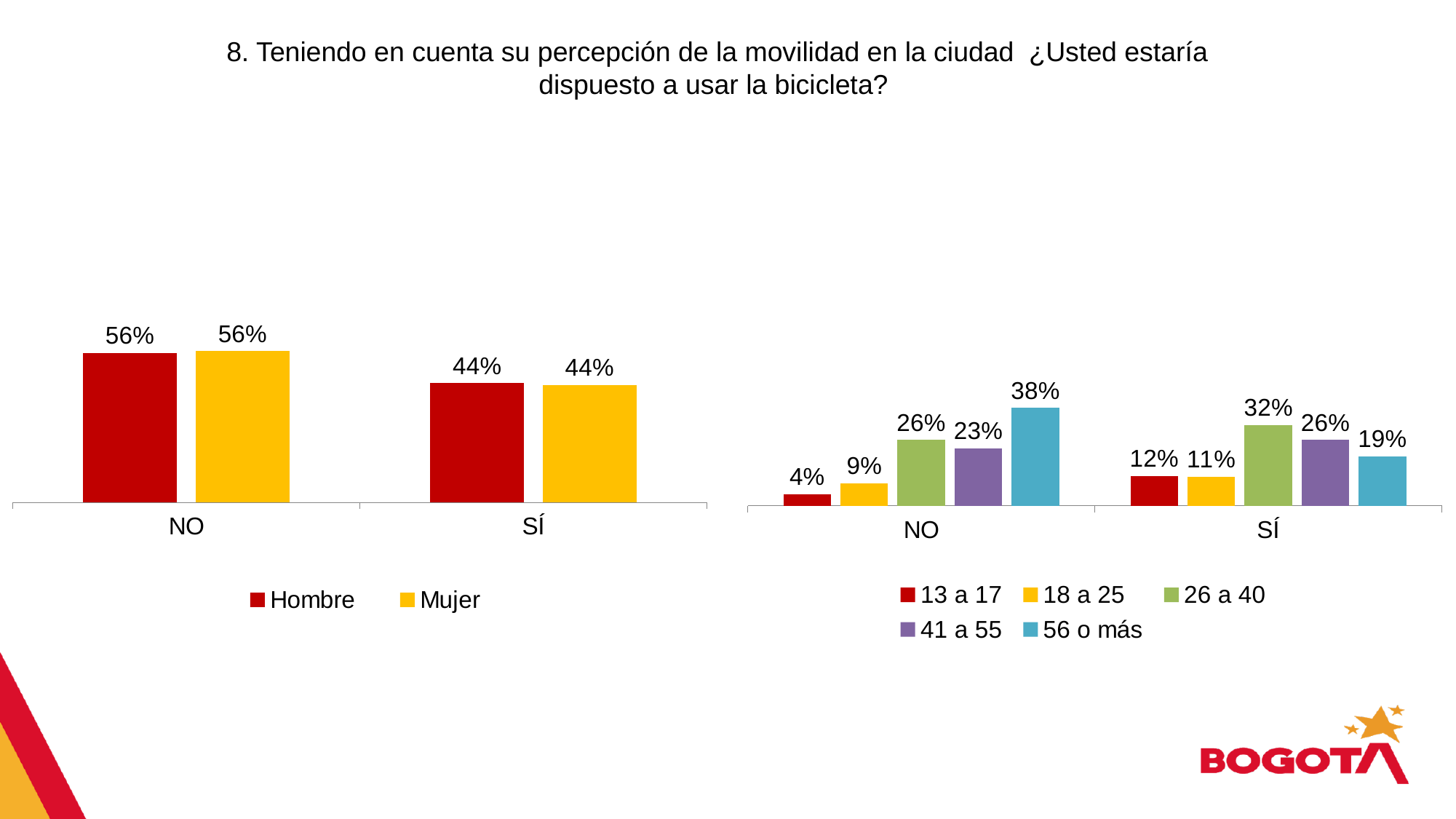
In the left chart (by gender), what is the value for Hombre in the NO category? 56% In the right chart (by age group), what is the value for 13 a 17 in the SÍ category? 12% In the right chart (by age group), which is larger: the 41 a 55 value for NO or for SÍ? SÍ In the right chart (by age group), which age group has the highest value in the SÍ category? 26 a 40 In the right chart (by age group), how many series does the legend list? 5 In the left chart (by gender), what is the value for Mujer in the SÍ category? 44% In the left chart (by gender), what is the difference between the Hombre values for NO and SÍ? 12% In the left chart (by gender), how many series does the legend list? 2 In the right chart (by age group), what is the difference between the 56 o más values for NO and SÍ? 19% In the right chart (by age group), what is the value for 56 o más in the NO category? 38% In the right chart (by age group), which age group has the lowest value in the NO category? 13 a 17 What kind of chart is the left chart (by gender)? Bar chart